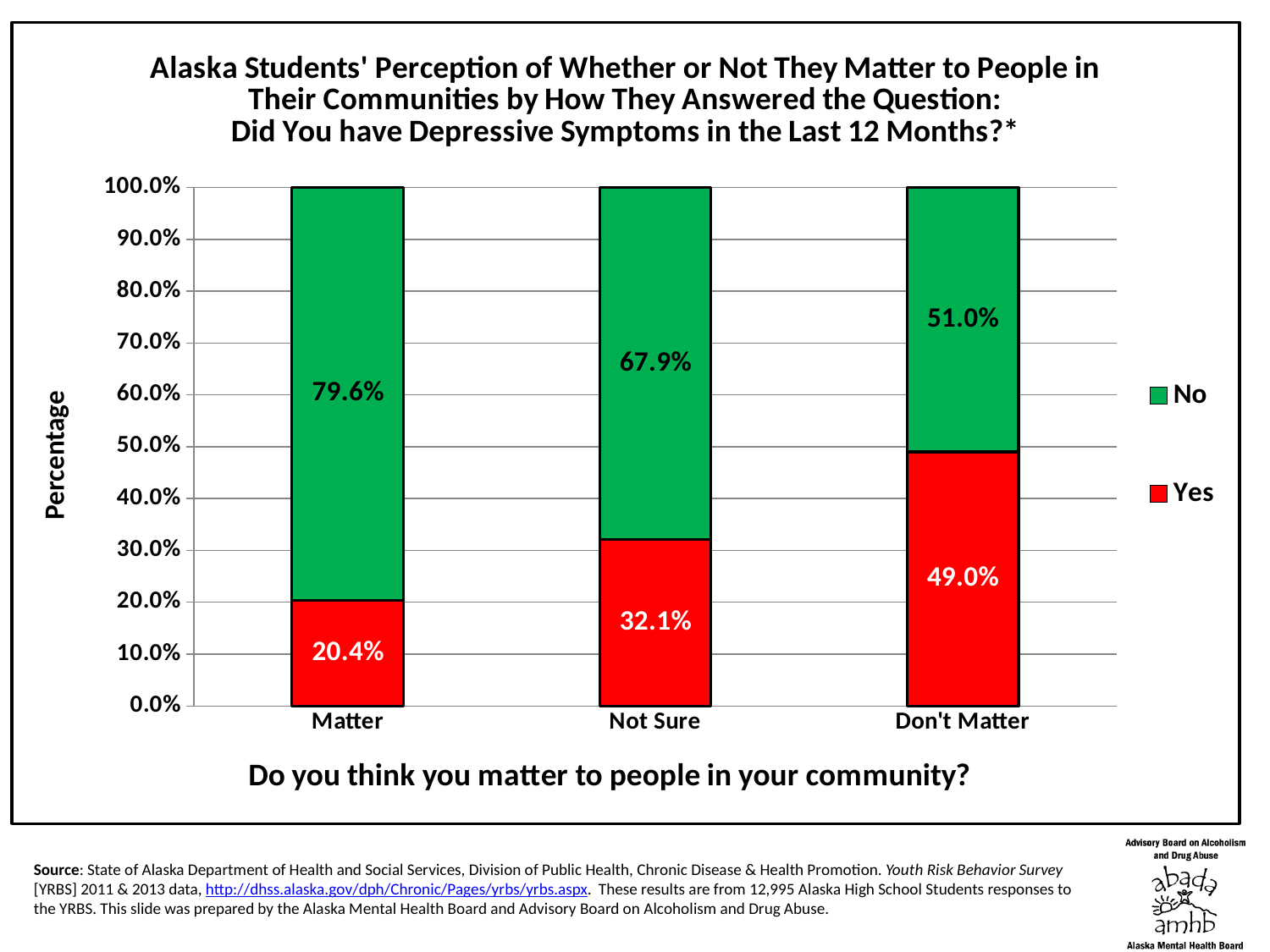
What is the "No" value for the "Not Sure" category? 67.9% How many series does the legend list? 2 What is the difference between the "Yes" values for "Don't Matter" and "Matter"? 28.6% How many categories are shown on the x axis? 3 Which category has the lowest "No" percentage? Don't Matter Which category has the highest "Yes" percentage? Don't Matter What percentage of students who answered "Matter" reported Yes to depressive symptoms? 20.4% Which is larger: the "No" value for "Matter" or the "No" value for "Not Sure"? Matter What is the total of the stacked bar for "Not Sure"? 100.0% What kind of chart is shown on the slide? Stacked bar chart Is the "Yes" value for "Not Sure" greater or less than 30.0%? greater What is the "Yes" value for the "Don't Matter" category? 49.0%